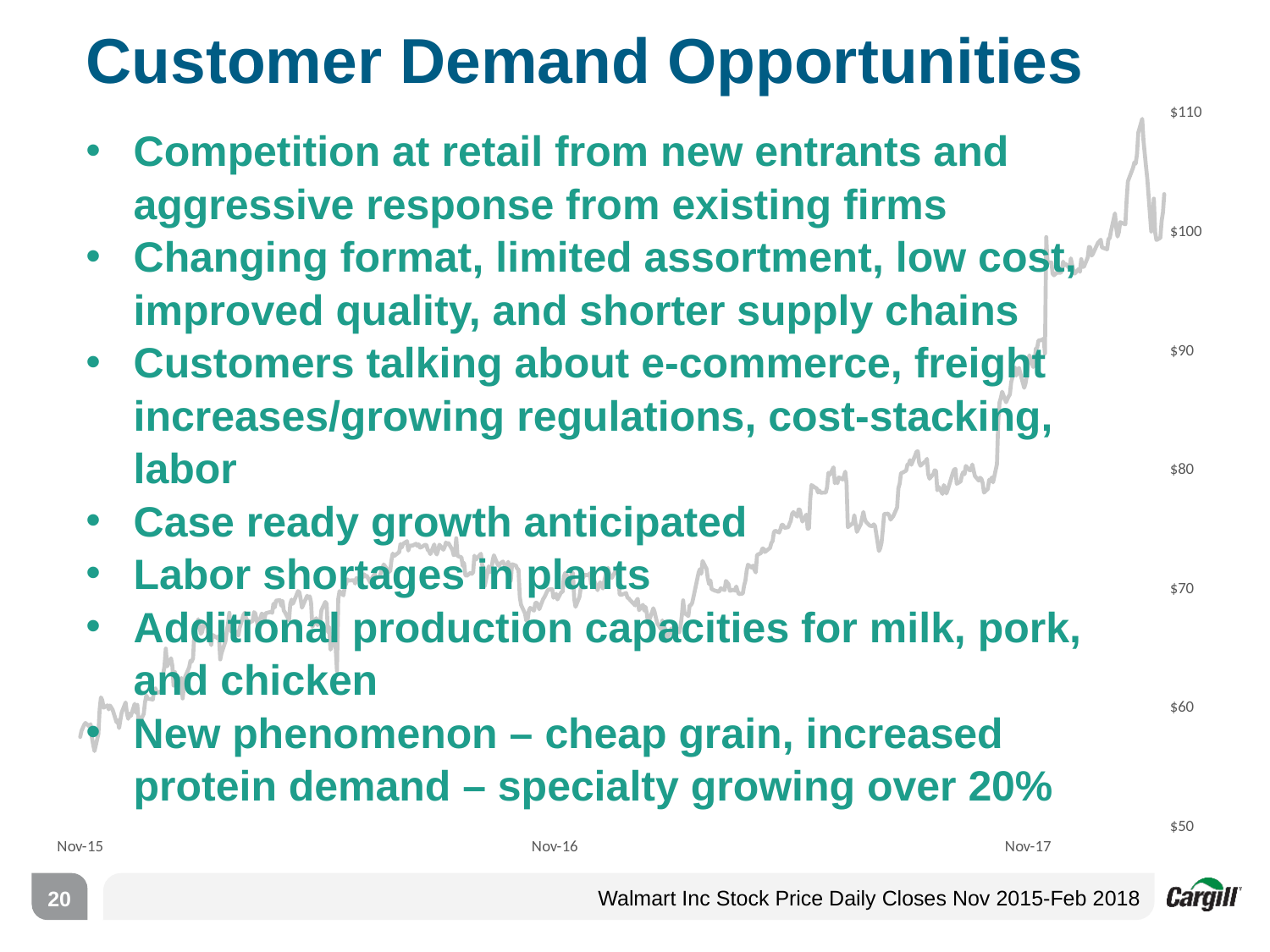
Does the stock price generally rise or fall from Nov-15 to the end of the chart? rise Is the stock price at Nov-17 greater or less than $80? greater How many lines (series) are plotted on the chart? 1 What kind of chart is shown on the slide? line chart Which is higher, the stock price at Nov-15 or at Nov-17? Nov-17 Is the stock price at Nov-15 greater or less than $70? less What is the highest value labelled on the y axis? $110 What is the title of the chart on the slide? Walmart Inc Stock Price Daily Closes Nov 2015-Feb 2018 How many date labels are shown on the x axis? 3 Is the stock price at Nov-16 greater or less than $60? greater